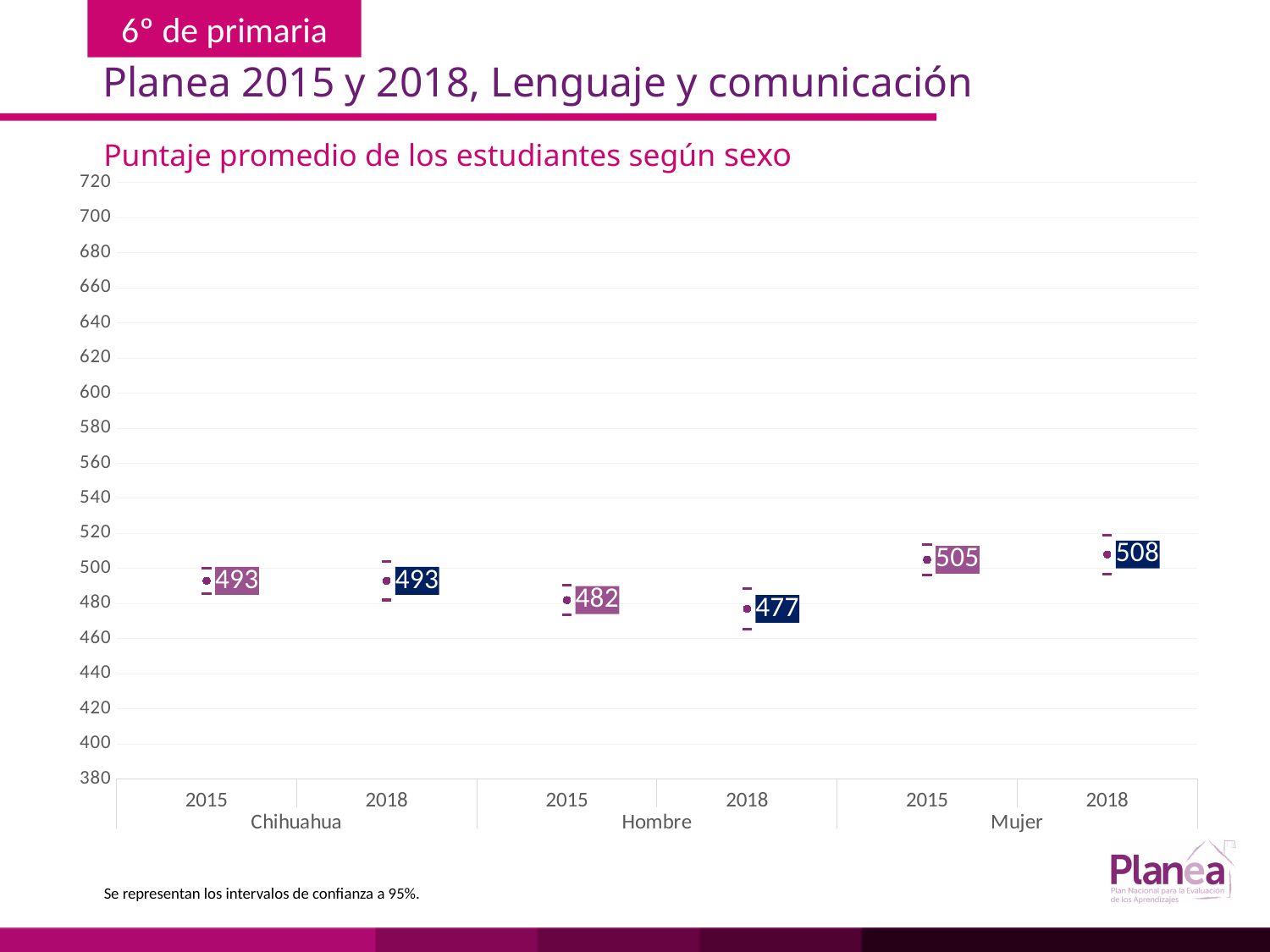
Which group and year has the lowest average score? Hombre 2018 What is the average score for Chihuahua in 2018? 493 What is the title of the chart? Puntaje promedio de los estudiantes según sexo What is the average score for Hombre in 2015? 482 What is the difference between the Mujer score in 2018 and the Hombre score in 2018? 31 How many data points are plotted on the chart? 6 Which group and year has the highest average score? Mujer 2018 Is the value for Mujer in 2015 greater or less than 500? greater Which is larger, the Hombre score in 2015 or the Hombre score in 2018? Hombre 2015 What is the average score for Hombre in 2018? 477 What is the difference between the Mujer score in 2015 and the Mujer score in 2018? 3 What is the average score for Mujer in 2018? 508